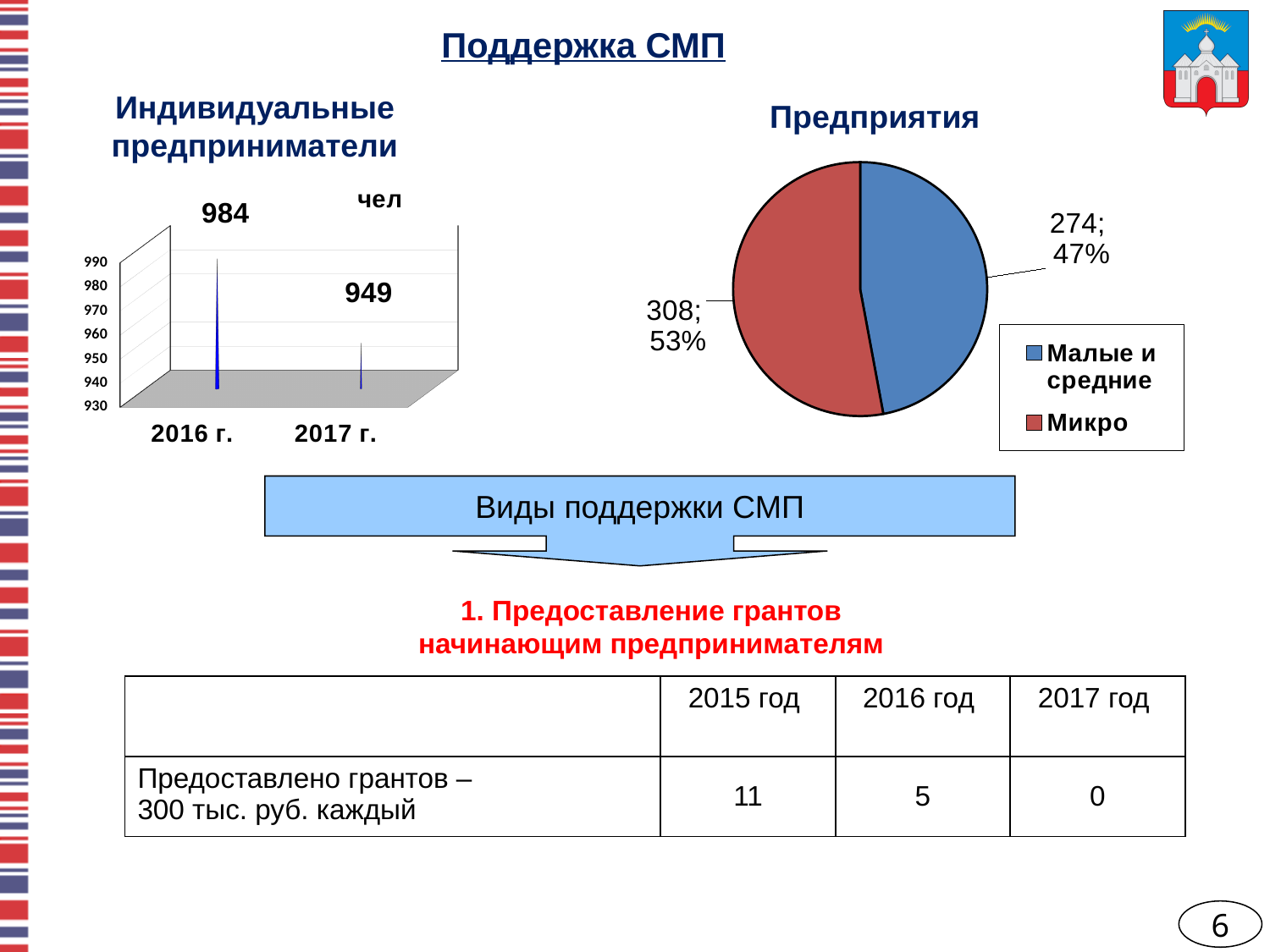
What kind of chart is the 'Индивидуальные предприниматели' chart? bar chart In the 'Предприятия' pie chart, what share does 'Малые и средние' have? 47% In the 'Индивидуальные предприниматели' chart, what is the difference between the 2016 г. and 2017 г. values? 35 In the 'Предприятия' pie chart, what colour is the 'Микро' slice? red How many categories are shown in the 'Индивидуальные предприниматели' chart? 2 In the 'Предприятия' pie chart, what is the value for 'Микро'? 308 In the 'Предприятия' pie chart, which slice is larger: 'Малые и средние' or 'Микро'? Микро In the 'Индивидуальные предприниматели' chart, which year has the higher value? 2016 г. How many entries does the legend of the 'Предприятия' pie chart list? 2 In the 'Индивидуальные предприниматели' chart, what is the value for 2016 г.? 984 In the 'Индивидуальные предприниматели' chart, what is the value for 2017 г.? 949 In the 'Индивидуальные предприниматели' chart, do the values rise or fall from 2016 г. to 2017 г.? fall